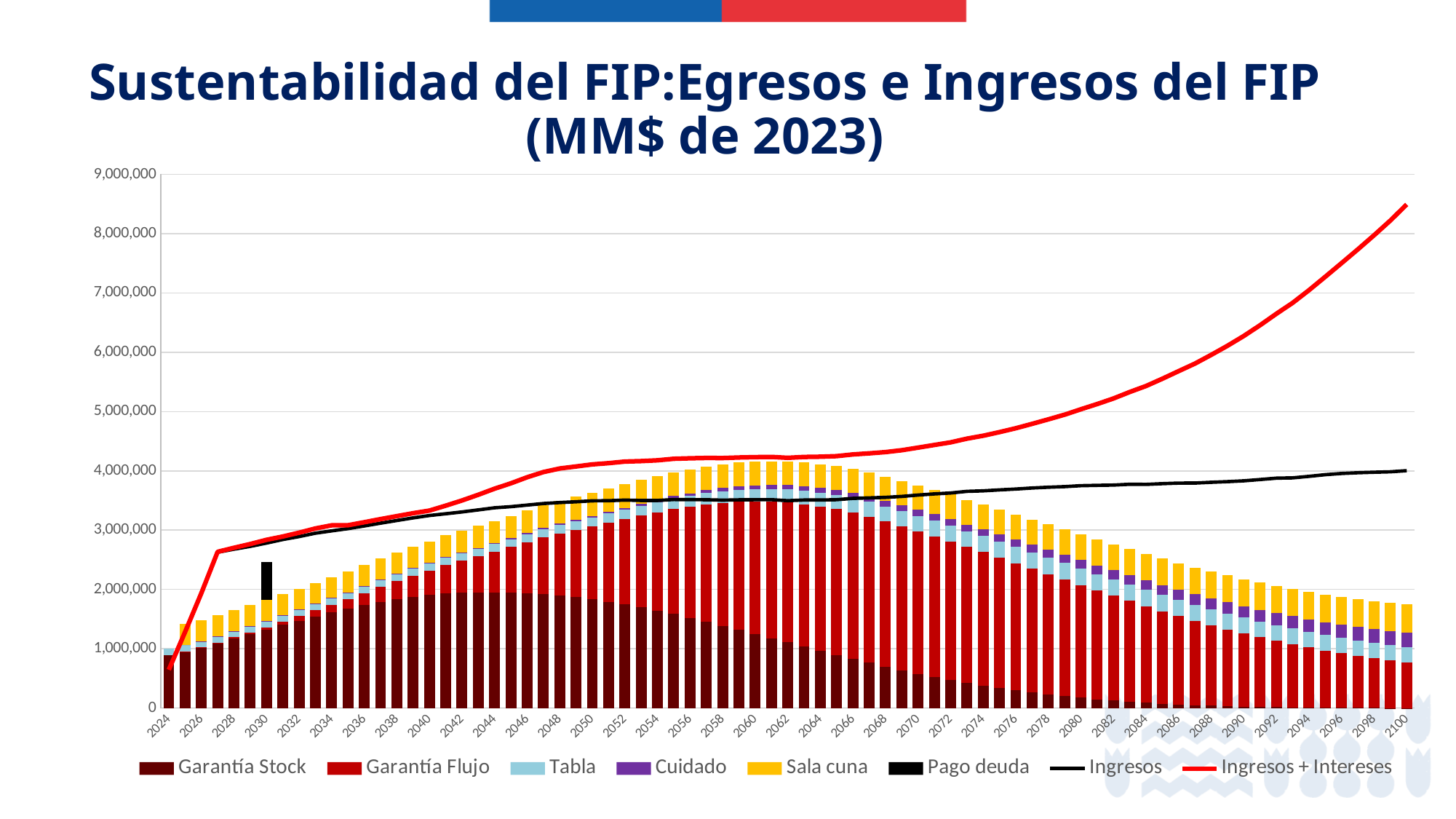
Does the Ingresos + Intereses line rise or fall from 2024 to 2100? Rise In which year does the Ingresos + Intereses line have its lowest value? 2024 What is the title of the chart on the slide? Sustentabilidad del FIP:Egresos e Ingresos del FIP (MM$ de 2023) Is the total height of the stacked bar for 2060 greater or less than 3,000,000? greater Is the value of the Ingresos + Intereses line in 2024 greater or less than 1,000,000? less How many series does the legend list? 8 Is the total height of the stacked bar for 2100 greater or less than 2,000,000? less Which colour represents the Sala cuna series in the legend? Yellow In which year does the Ingresos + Intereses line reach its highest value? 2100 In 2100, which is larger: the Ingresos line or the Ingresos + Intereses line? Ingresos + Intereses What kind of chart is shown on the slide? A stacked bar chart combined with line series